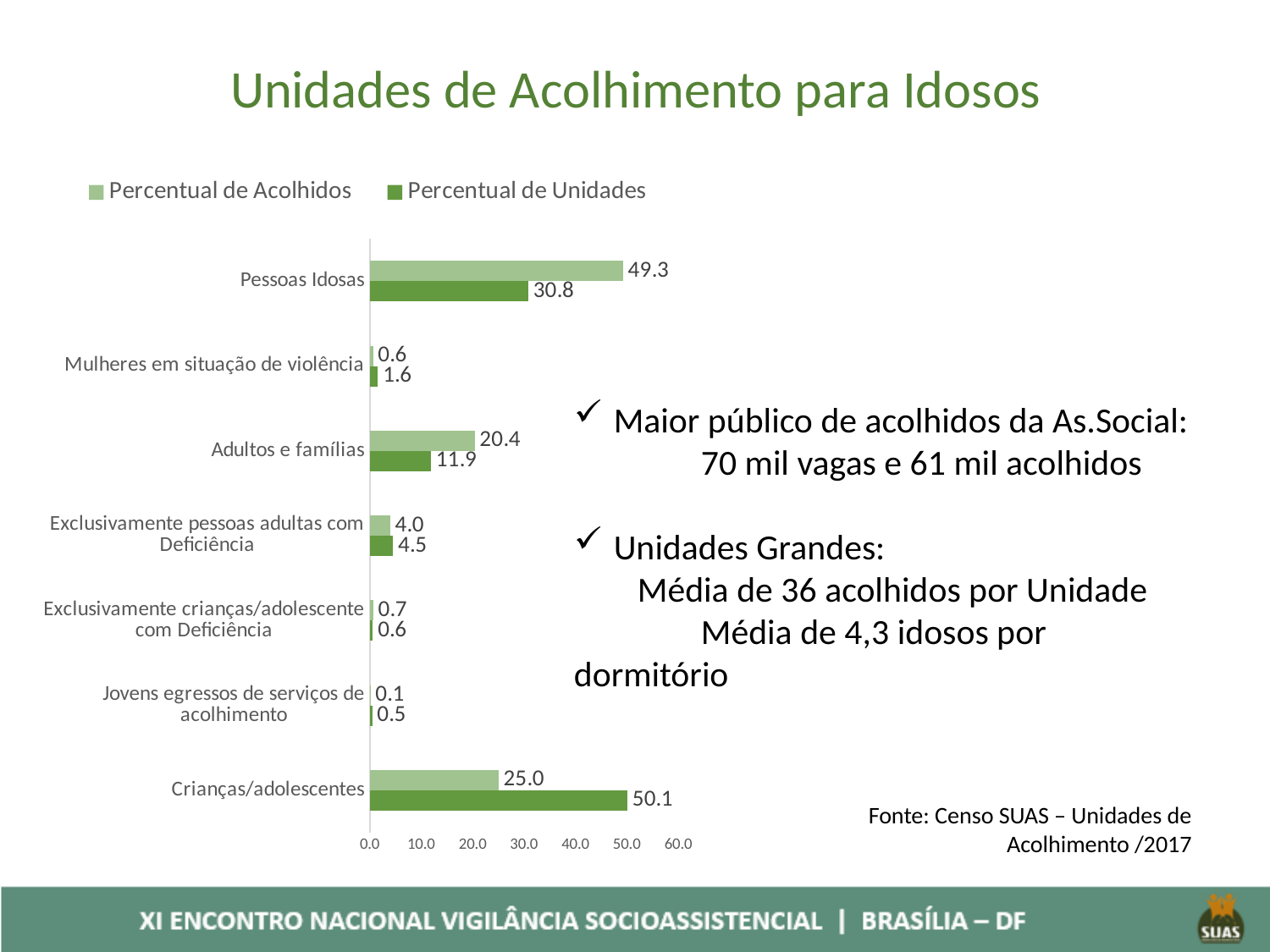
How many series does the legend list? 2 For Crianças/adolescentes, which is larger: Percentual de Acolhidos or Percentual de Unidades? Percentual de Unidades What is the Percentual de Acolhidos value for Mulheres em situação de violência? 0.6 How many categories are shown on the chart? 7 Which category has the highest Percentual de Acolhidos? Pessoas Idosas What is the Percentual de Unidades value for Crianças/adolescentes? 50.1 Which category has the highest Percentual de Unidades? Crianças/adolescentes What is the Percentual de Acolhidos value for Pessoas Idosas? 49.3 What is the difference between Percentual de Acolhidos and Percentual de Unidades for Pessoas Idosas? 18.5 What kind of chart is shown on the slide? Bar chart What is the Percentual de Unidades value for Adultos e famílias? 11.9 Which category has the lowest Percentual de Acolhidos? Jovens egressos de serviços de acolhimento